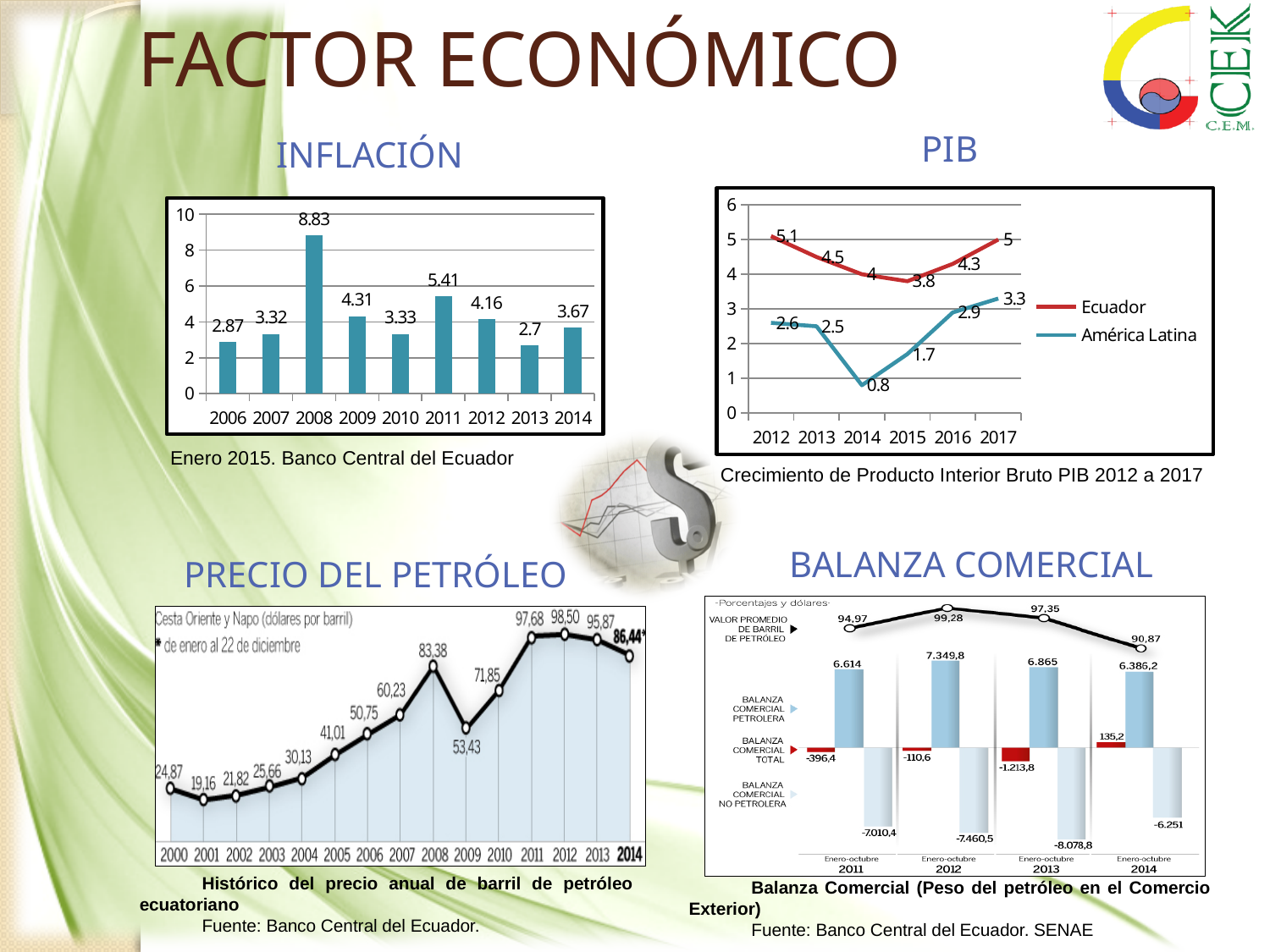
In the INFLACIÓN chart, what is the difference between the values for 2011 and 2012? 1.25 In the PRECIO DEL PETRÓLEO chart, which year has the lowest value? 2001 What kind of chart is the INFLACIÓN chart? Bar chart In the INFLACIÓN chart, what is the value for 2008? 8.83 In the PRECIO DEL PETRÓLEO chart, what is the value for 2012? 98,50 In the INFLACIÓN chart, which year has the lowest value? 2013 In the BALANZA COMERCIAL chart, what is the Balanza Comercial Total value for Enero-octubre 2013? -1.213,8 In the BALANZA COMERCIAL chart, what is the Balanza Comercial Petrolera value for Enero-octubre 2012? 7.349,8 In the PIB chart, which is larger in 2016: Ecuador or América Latina? Ecuador In the PIB chart, how many series does the legend list? 2 In the PIB chart, what is the value for América Latina in 2014? 0.8 In the PIB chart, how many years are shown on the x axis? 6